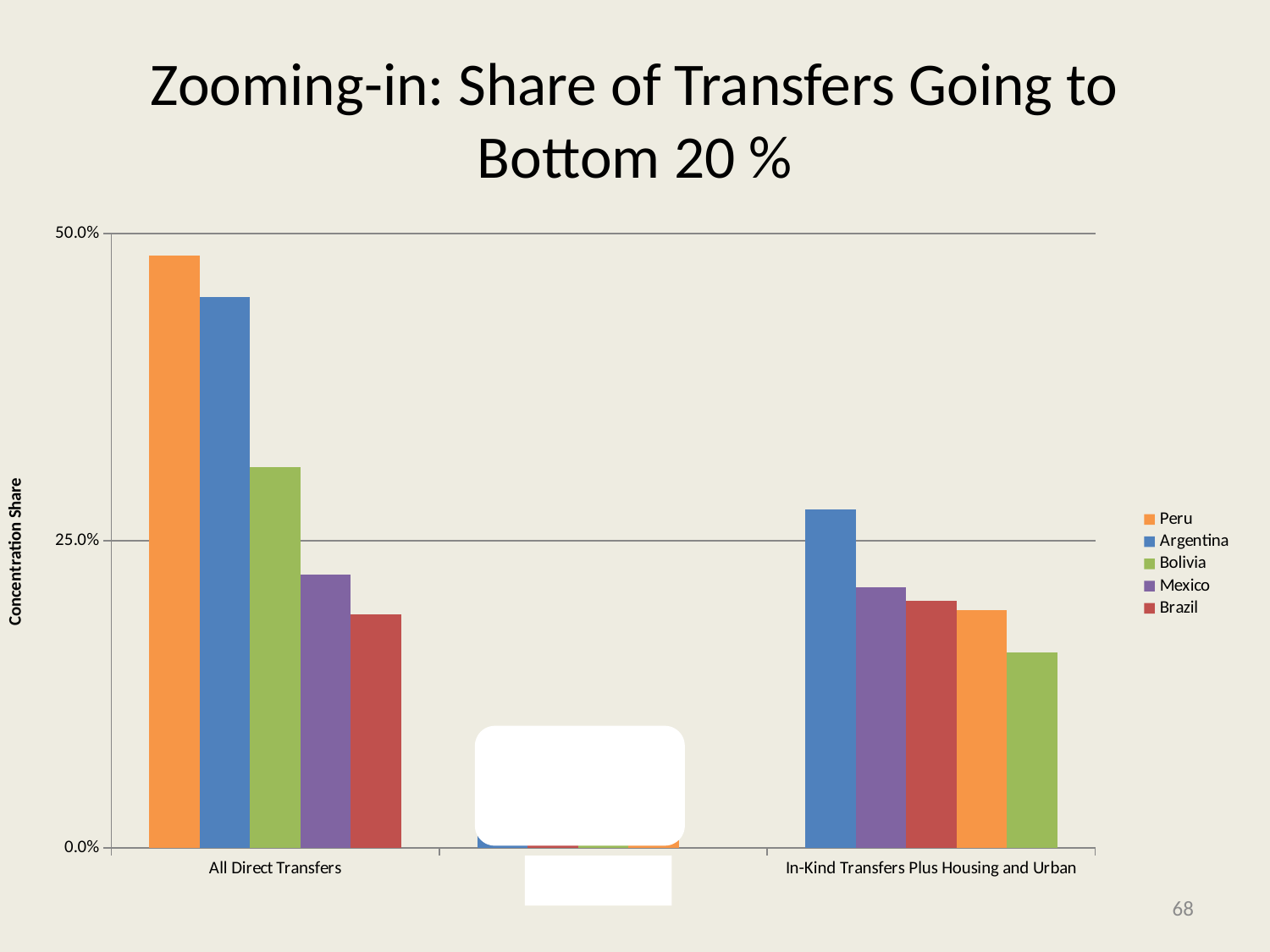
Which country has the lowest value for In-Kind Transfers Plus Housing and Urban? Bolivia Which country has the highest value for In-Kind Transfers Plus Housing and Urban? Argentina Is the value for Argentina under In-Kind Transfers Plus Housing and Urban greater or less than 25.0%? greater What is the label on the vertical axis of the chart? Concentration Share Is the value for Peru under All Direct Transfers greater or less than 25.0%? greater Which country has the highest value for All Direct Transfers? Peru Is the value for Brazil under All Direct Transfers greater or less than 25.0%? less Which is larger for All Direct Transfers: Peru or Argentina? Peru Which country has the lowest value for All Direct Transfers? Brazil How many series does the legend list? 5 What kind of chart is shown on the slide? bar chart Is Argentina's value larger for All Direct Transfers or for In-Kind Transfers Plus Housing and Urban? All Direct Transfers